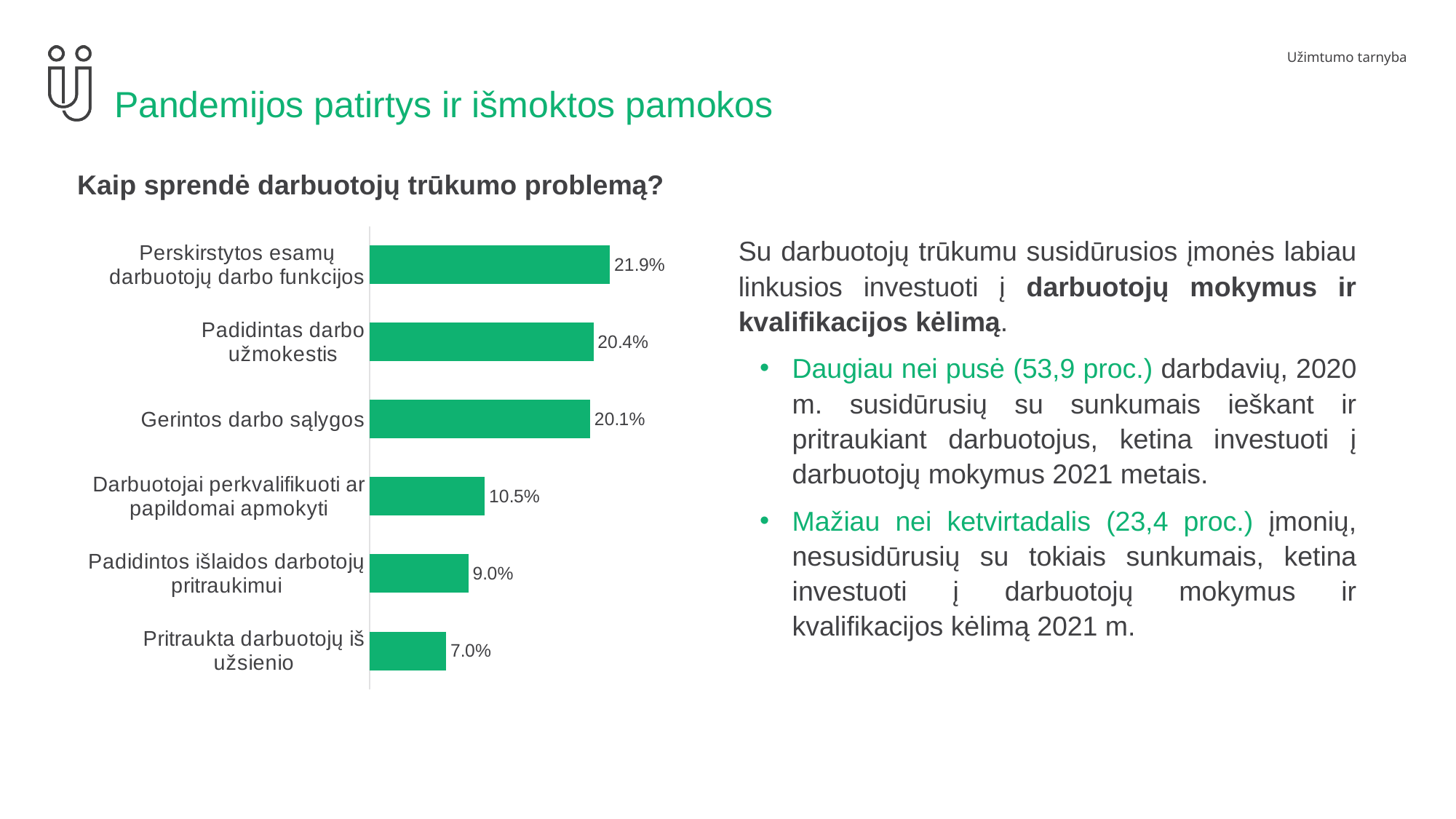
What is the value for "Gerintos darbo sąlygos"? 20.1% How many categories are shown in the chart? 6 What is the value for "Padidintas darbo užmokestis"? 20.4% What kind of chart is shown on the slide? Bar chart What is the difference between the highest and lowest values in the chart? 14.9% Which category has the highest value? Perskirstytos esamų darbuotojų darbo funkcijos What is the heading above the chart? Kaip sprendė darbuotojų trūkumo problemą? What is the value for "Perskirstytos esamų darbuotojų darbo funkcijos"? 21.9% What is the difference between "Darbuotojai perkvalifikuoti ar papildomai apmokyti" and "Padidintos išlaidos darbotojų pritraukimui"? 1.5% Which category has the lowest value? Pritraukta darbuotojų iš užsienio What is the value for "Pritraukta darbuotojų iš užsienio"? 7.0% Which is larger: "Darbuotojai perkvalifikuoti ar papildomai apmokyti" or "Pritraukta darbuotojų iš užsienio"? Darbuotojai perkvalifikuoti ar papildomai apmokyti